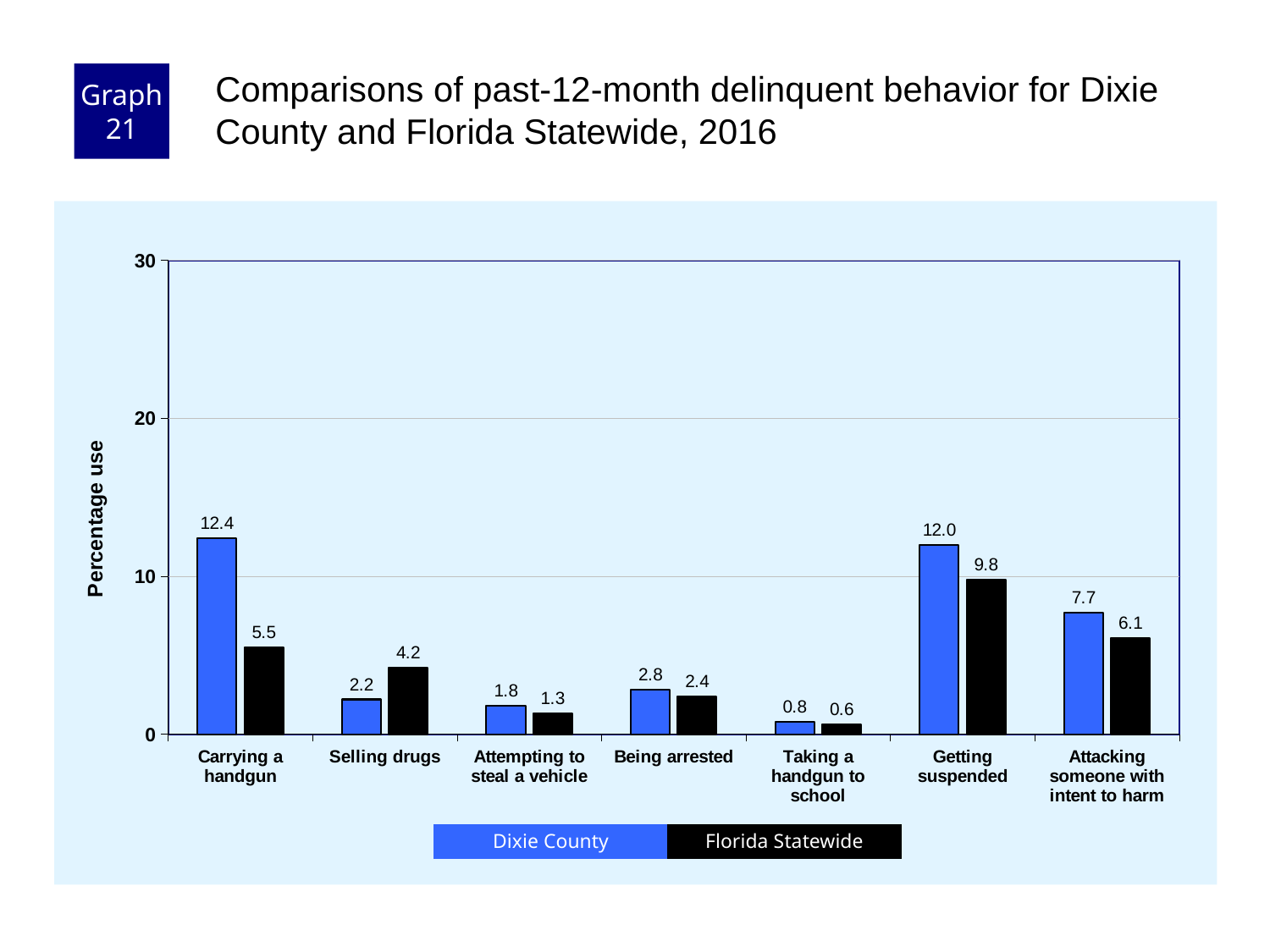
What is the Dixie County value for Carrying a handgun? 12.4 Which is larger for Selling drugs: the Dixie County value or the Florida Statewide value? Florida Statewide What is the difference between the Dixie County and Florida Statewide values for Carrying a handgun? 6.9 What is the Dixie County value for Taking a handgun to school? 0.8 Which category has the lowest Florida Statewide value? Taking a handgun to school What kind of chart is shown on the slide? Bar chart How many categories are shown on the x axis? 7 What is the label of the y axis? Percentage use What is the Florida Statewide value for Getting suspended? 9.8 Which category has the highest Dixie County value? Carrying a handgun Is the Dixie County value for Getting suspended greater or less than 10? greater How many series does the legend list? 2